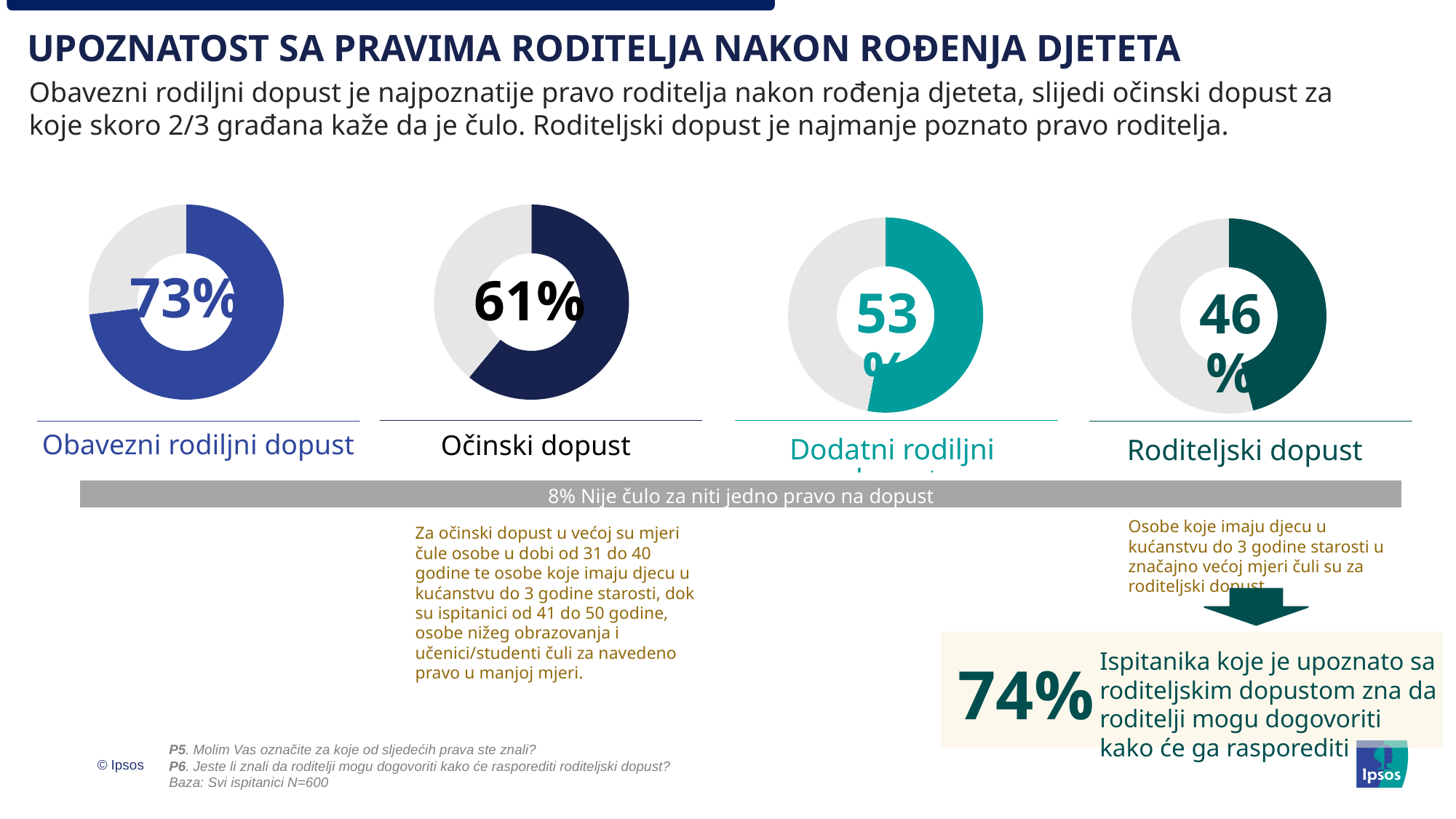
What value is shown in the third donut chart from the left (Dodatni rodiljni dopust)? 53% What is the difference between the values shown for Očinski dopust and the third donut chart (Dodatni rodiljni dopust)? 8 percentage points What value is shown in the donut chart labelled "Roditeljski dopust"? 46% What value is shown in the donut chart labelled "Očinski dopust"? 61% Do the values of the donut charts rise or fall when read from left to right across the slide? Fall What value is shown in the donut chart labelled "Obavezni rodiljni dopust"? 73% What type of chart is used to display the percentages on the slide? Donut (pie) chart Which is larger: the value for Očinski dopust or the value for Roditeljski dopust? Očinski dopust Which of the four donut charts shows the highest value? Obavezni rodiljni dopust Which of the four donut charts shows the lowest value? Roditeljski dopust How many donut charts are shown on the slide? 4 What is the difference between the values shown for Obavezni rodiljni dopust and Roditeljski dopust? 27 percentage points